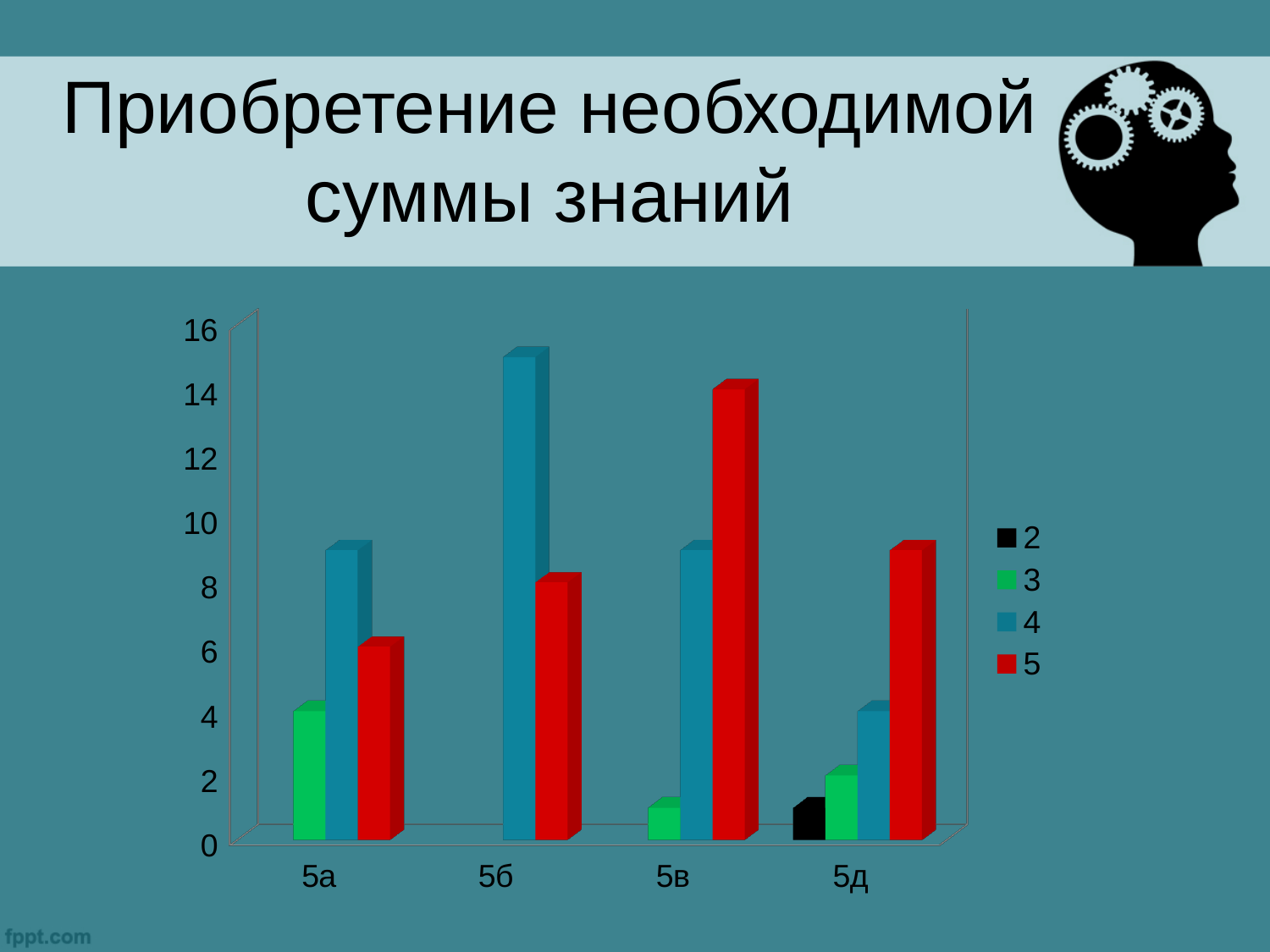
Is the value of series 4 for category 5б greater or less than 14? greater How many categories are shown on the x axis? 4 Which category has the highest value for series 4? 5б What kind of chart is shown on the slide? bar chart Which category has the highest value for series 5? 5в What is the value of series 5 for category 5б? 8 What is the value of series 4 for category 5д? 4 What is the value of series 3 for category 5а? 4 What is the value of series 5 for category 5в? 14 How many series does the legend list? 4 What are the legend entries of the chart? 2, 3, 4, 5 Which is larger for category 5а: series 4 or series 5? series 4